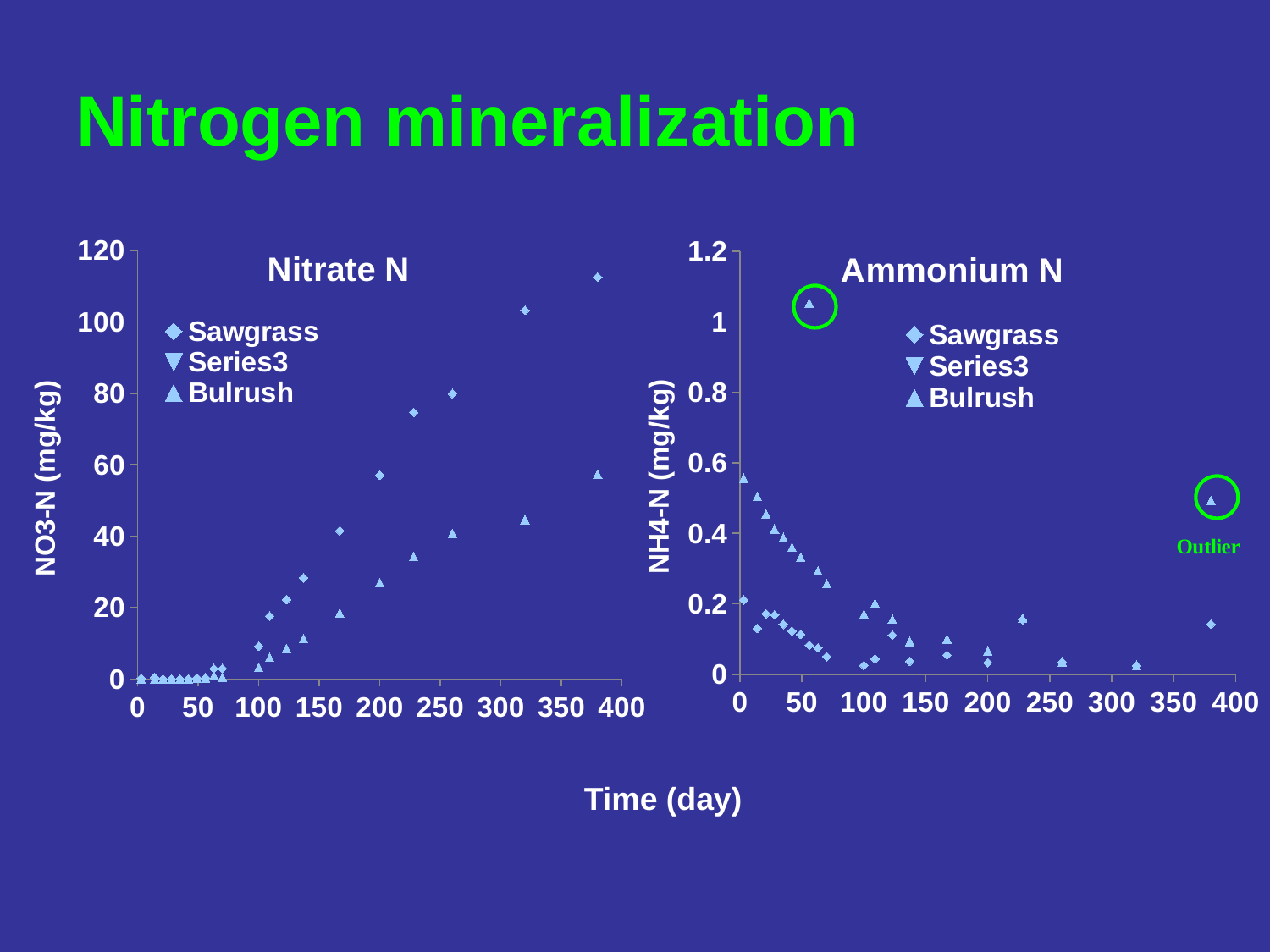
How many series does the legend of the Ammonium N chart list? 3 In the Nitrate N chart, at about day 320, which series has the larger value, Sawgrass or Bulrush? Sawgrass In the Ammonium N chart, is the circled Bulrush point at about day 380 greater or less than 0.4? greater What is the shared x-axis label for the two charts? Time (day) In the Nitrate N chart, do the Sawgrass values generally rise or fall as time increases? rise In the Nitrate N chart, is the Sawgrass value at about day 380 greater or less than 100? greater In the Ammonium N chart, do the Sawgrass values generally rise or fall over the first 100 days? fall In the Nitrate N chart, is the Bulrush value at about day 380 greater or less than 40? greater What kind of chart is the Nitrate N chart? scatter chart In the Ammonium N chart, which series reaches the highest plotted value? Bulrush What is the y-axis label of the Nitrate N chart? NO3-N (mg/kg)